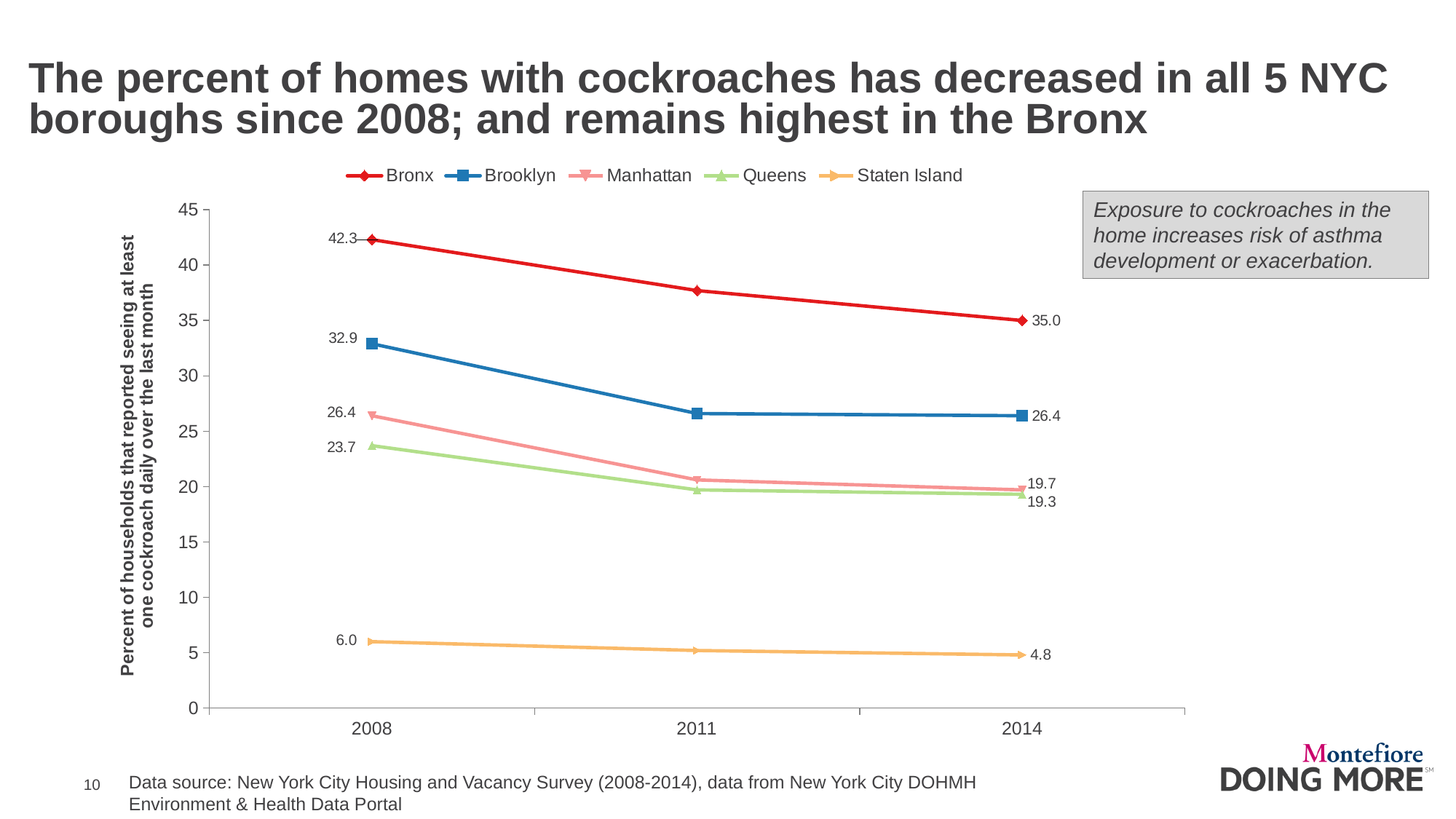
How many series does the legend list? 5 What was the value for the Bronx in 2008? 42.3 Which borough had the highest value in 2014? Bronx What is the difference between Brooklyn's 2008 value and its 2014 value? 6.5 Which borough had the lowest value in 2008? Staten Island Which was larger in 2008, Manhattan or Queens? Manhattan By how much did the Bronx value fall from 2008 to 2014? 7.3 What was the value for Manhattan in 2014? 19.7 What was the value for Queens in 2008? 23.7 What was the value for Staten Island in 2014? 4.8 What kind of chart is shown on the slide? Line chart Is the value for the Bronx in 2011 greater or less than 35? greater